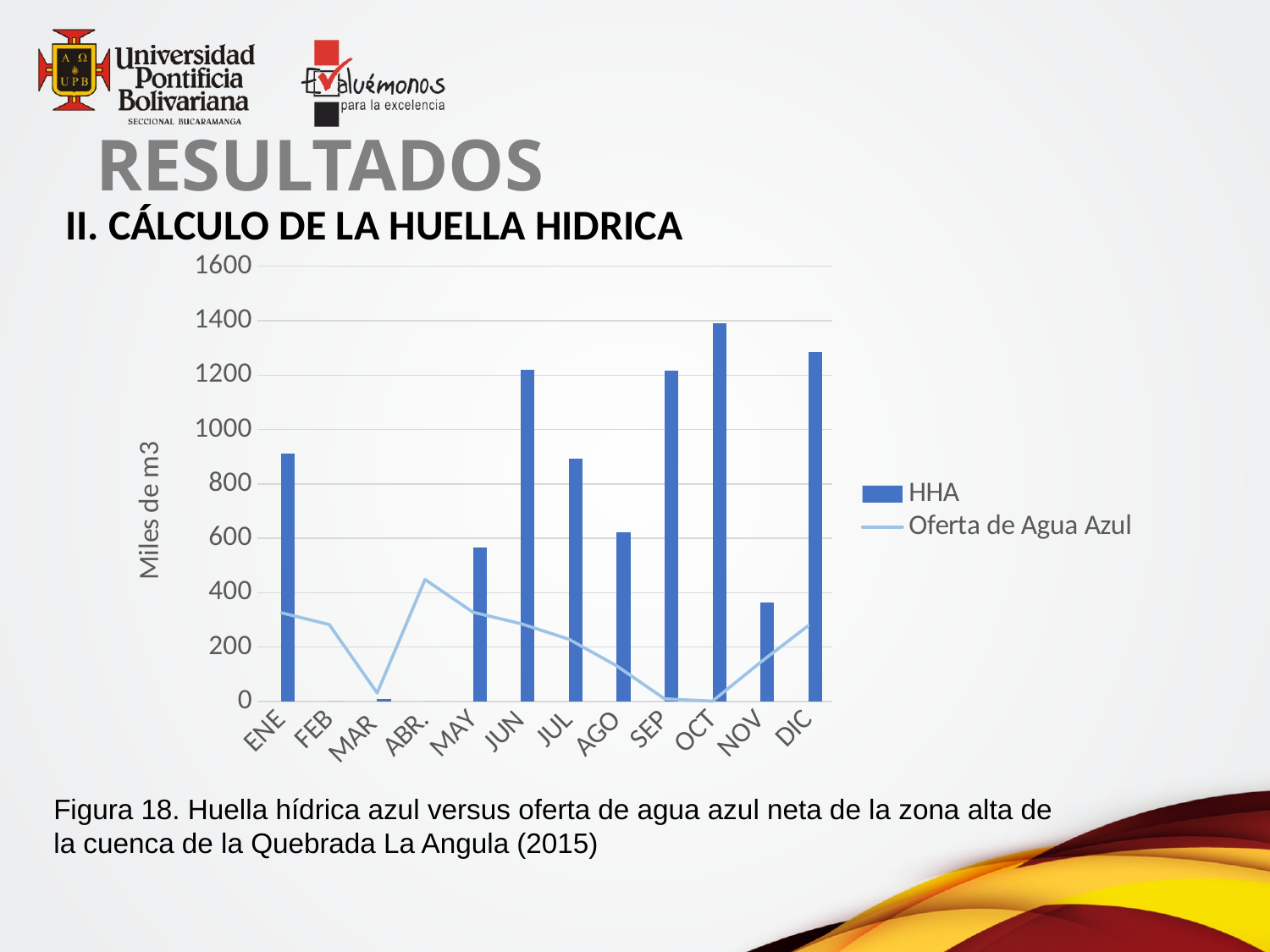
Is the HHA value for NOV greater or less than 400? less Which month has the highest HHA bar? OCT Which series is drawn as a line? Oferta de Agua Azul Which is larger, the HHA value for JUN or the HHA value for JUL? JUN Is the Oferta de Agua Azul value for ABR. greater or less than 400? greater What kind of chart is shown on the slide? A combined bar and line chart Is the HHA value for OCT greater or less than 1200? greater How many series does the legend list? 2 How many months are shown along the x axis? 12 Which is larger in MAY, the HHA value or the Oferta de Agua Azul value? HHA What is the title of the y axis? Miles de m3